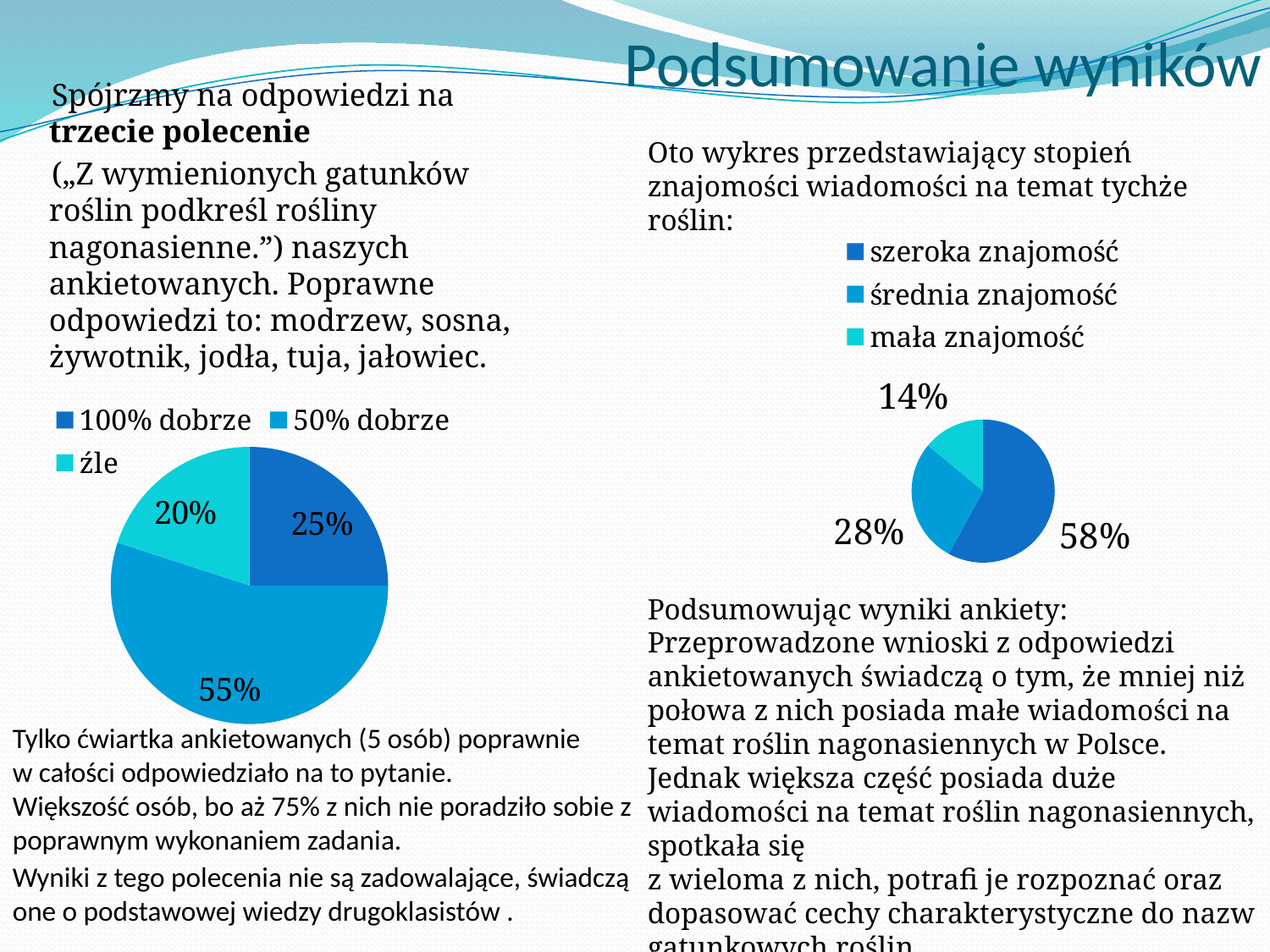
On the left pie chart, what share is labelled for "źle"? 20% What type of chart is the right chart? pie chart On the left pie chart, what share is labelled for "50% dobrze"? 55% On the right pie chart, which is larger: "średnia znajomość" or "mała znajomość"? średnia znajomość On the right pie chart, what share is labelled for "mała znajomość"? 14% On the left pie chart, what is the difference between the "50% dobrze" and "100% dobrze" shares? 30% On the left pie chart, what share is labelled for "100% dobrze"? 25% On the right pie chart, which category has the largest slice? szeroka znajomość On the left pie chart, how many slices are there? 3 On the right pie chart, what share is labelled for "szeroka znajomość"? 58% On the left pie chart, which category has the largest slice? 50% dobrze On the left pie chart, which category has the smallest slice? źle